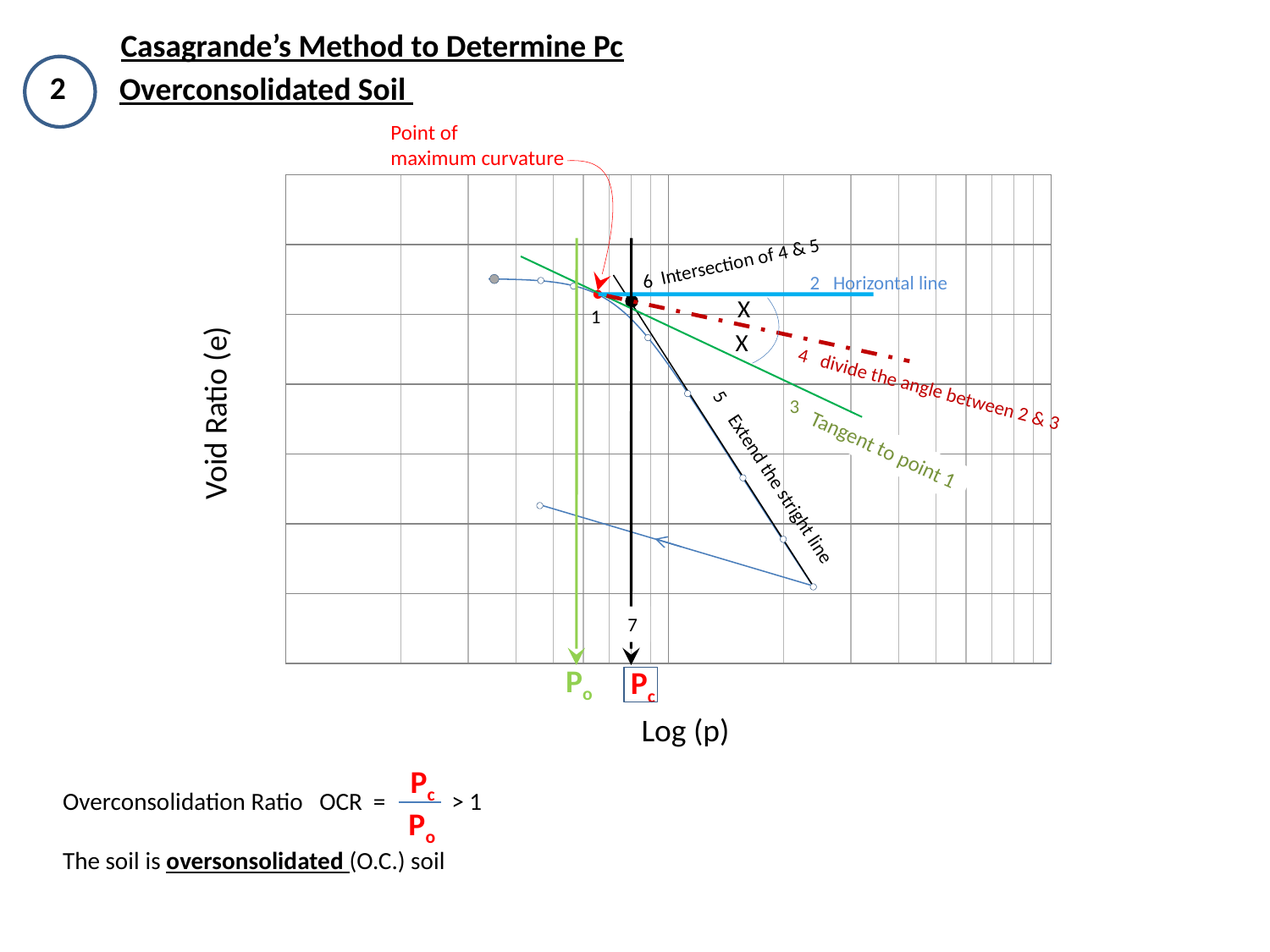
Which is larger on the Log (p) axis, Pc or Po? Pc What is the label of the horizontal axis? Log (p) Does the void ratio rise or fall as Log (p) increases along the x axis? fall What kind of chart is shown on the slide? line chart What is the label of the vertical axis? Void Ratio (e)